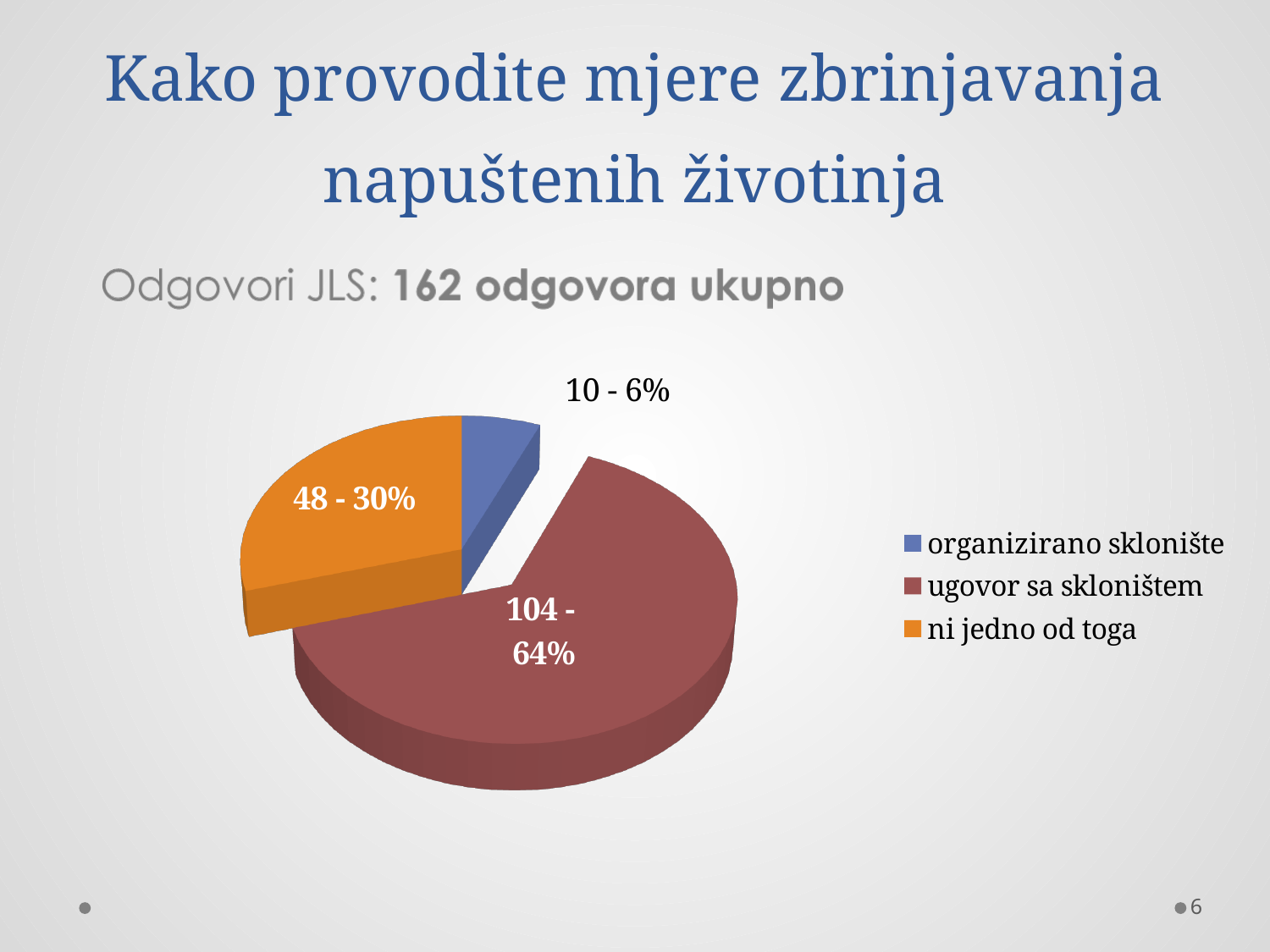
What is the difference in count between 'ugovor sa skloništem' and 'ni jedno od toga'? 56 Which is larger, 'ni jedno od toga' or 'organizirano sklonište'? ni jedno od toga Which category has the smallest slice of the pie? organizirano sklonište Which category has the largest slice of the pie? ugovor sa skloništem What percentage share of the pie does 'ni jedno od toga' have? 30% What kind of chart is shown on the slide? pie chart What is the data label for the 'ugovor sa skloništem' slice? 104 - 64% What is the data label for the 'ni jedno od toga' slice? 48 - 30% What is the data label for the 'organizirano sklonište' slice? 10 - 6% How many slices does the pie chart have? 3 How many entries does the legend list? 3 What colour is the 'ni jedno od toga' slice? orange